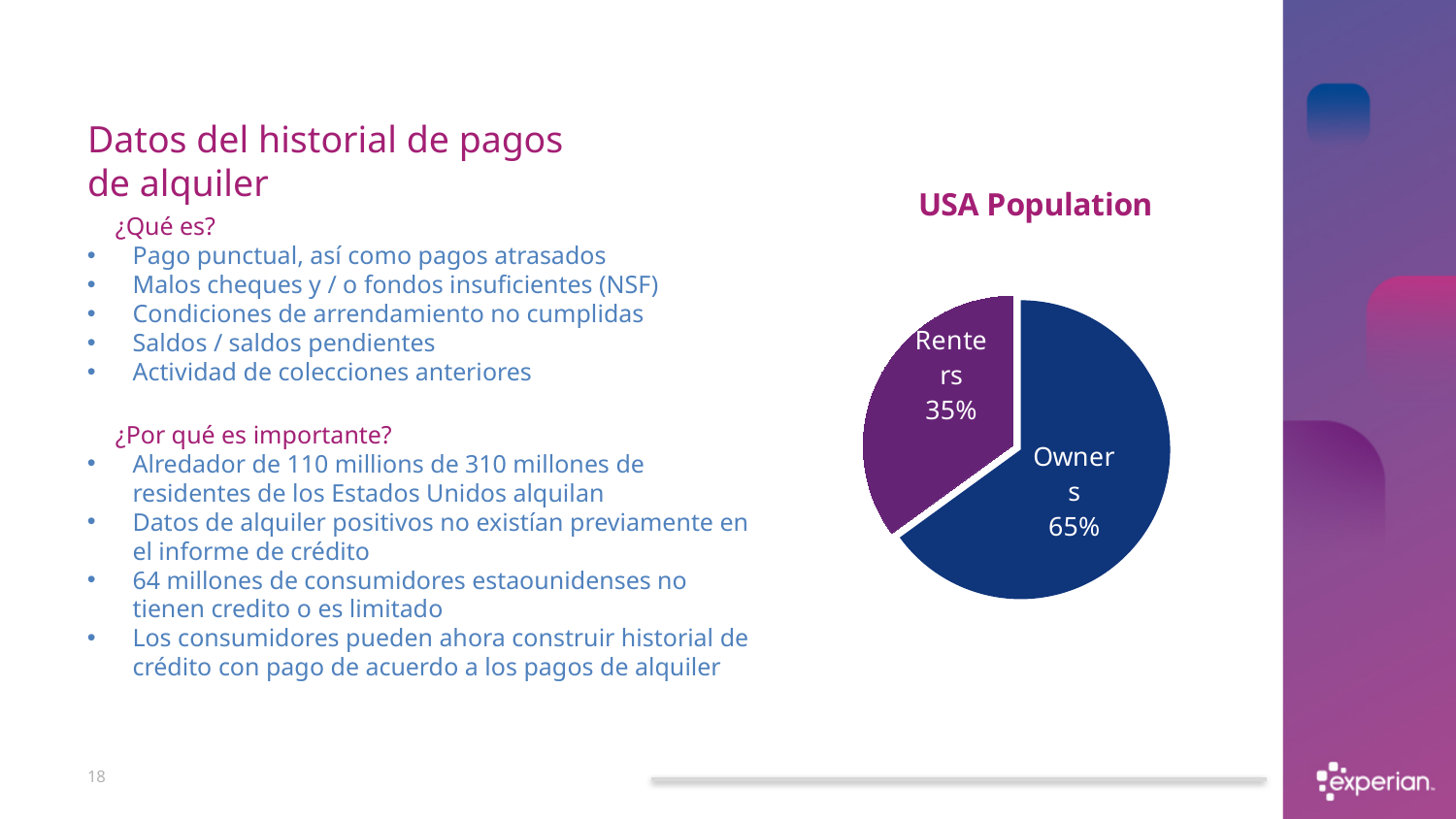
Which slice of the USA Population pie is the largest? Owners Which is larger in the USA Population pie, Owners or Renters? Owners What colour is the Renters slice in the USA Population pie? purple What share of the USA Population pie is Renters? 35% What is the title of the chart on the slide? USA Population What is the difference in percentage points between the Owners and Renters slices? 30 What share of the USA Population pie is Owners? 65% Which slice of the USA Population pie is the smallest? Renters How many slices does the USA Population pie chart have? 2 What kind of chart is shown on the slide? pie chart